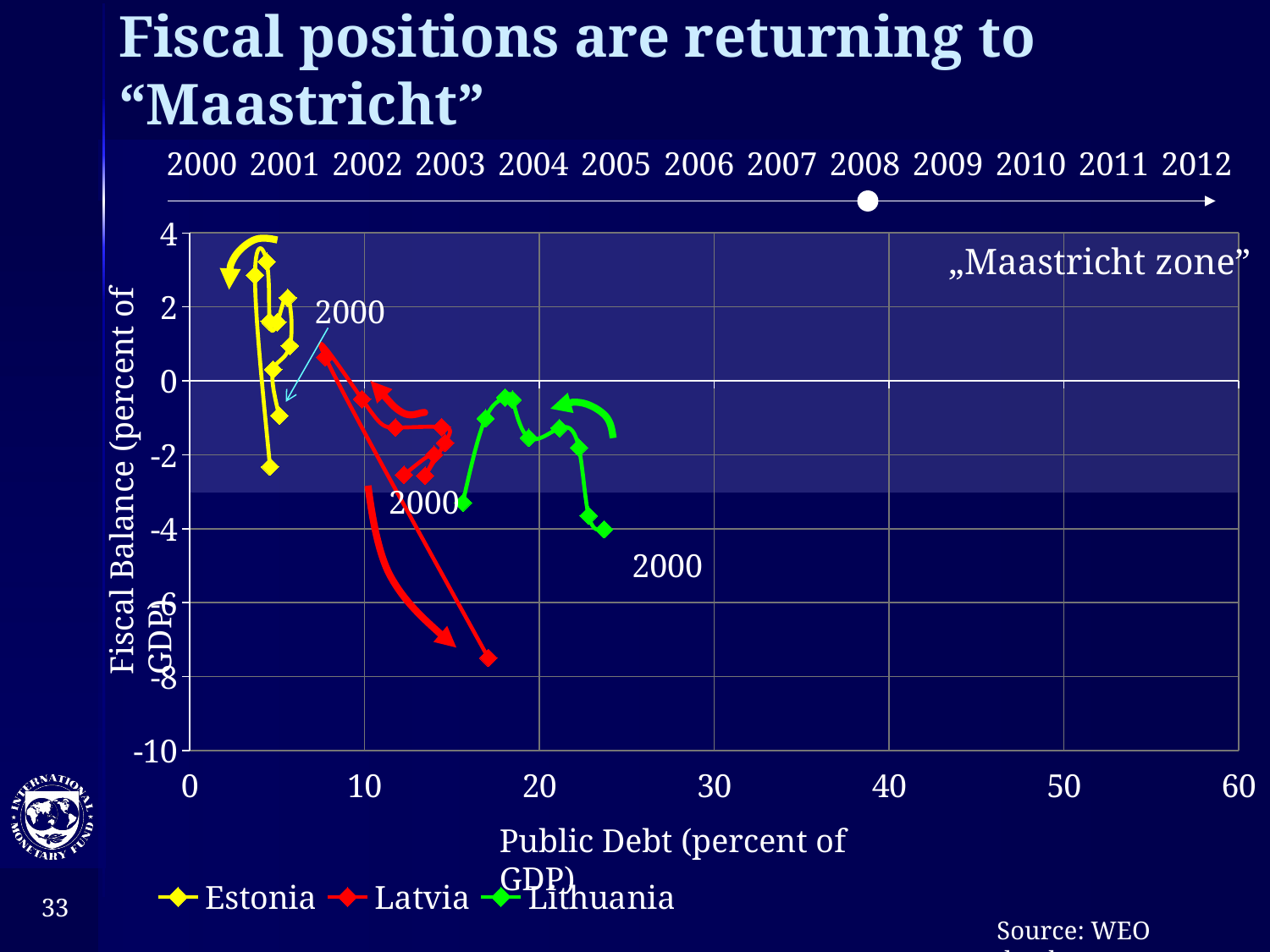
Which series has the lowest public debt values on the chart? Estonia Is the fiscal balance for Lithuania in 2000 greater or less than -2? less Which series reaches the lowest fiscal balance on the chart? Latvia Is the public debt for Latvia in 2000 greater or less than 10? greater What is the title of the horizontal axis? Public Debt (percent of GDP) What kind of chart is shown on the slide? scatter chart Which countries are listed in the chart legend? Estonia, Latvia, Lithuania Is the highest fiscal balance for Estonia greater or less than 2? greater How many series does the legend list? 3 Which series reaches the highest public debt on the chart? Lithuania